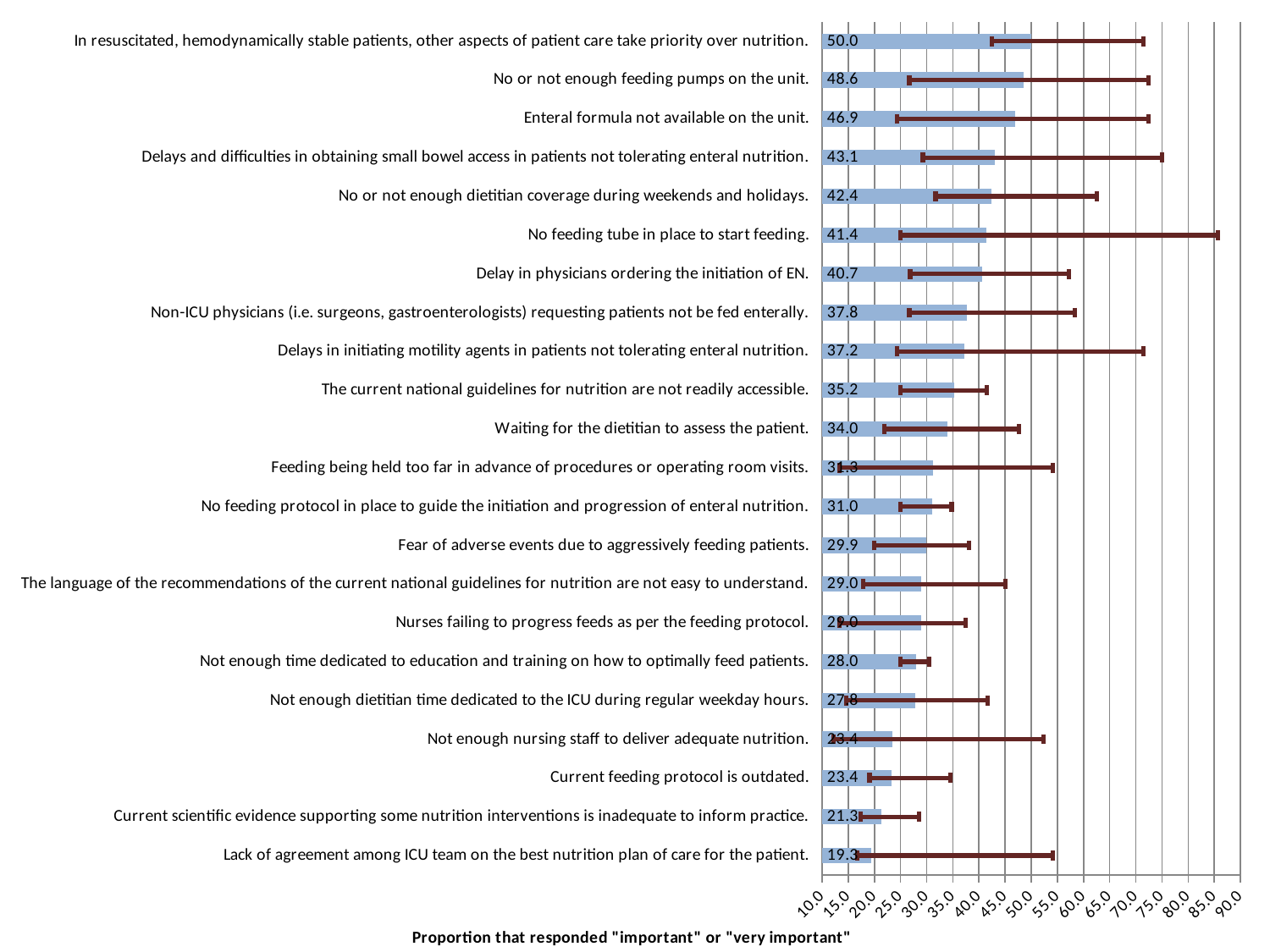
What is the value for "Fear of adverse events due to aggressively feeding patients."? 29.9 What kind of chart is shown on the slide? bar chart What is the value for "Delay in physicians ordering the initiation of EN."? 40.7 How many categories are shown in the chart? 22 Is the value for "No feeding tube in place to start feeding." greater or less than 40.0? greater Which category has the lowest value? Lack of agreement among ICU team on the best nutrition plan of care for the patient. What is the difference between the values for "Enteral formula not available on the unit." and "Delays and difficulties in obtaining small bowel access in patients not tolerating enteral nutrition."? 3.8 What is the value for "No or not enough feeding pumps on the unit."? 48.6 Which is larger: the value for "No or not enough dietitian coverage during weekends and holidays." or for "Not enough time dedicated to education and training on how to optimally feed patients."? No or not enough dietitian coverage during weekends and holidays. What is the value for "Waiting for the dietitian to assess the patient."? 34.0 What is the value for "Enteral formula not available on the unit."? 46.9 Which category has the highest value? In resuscitated, hemodynamically stable patients, other aspects of patient care take priority over nutrition.